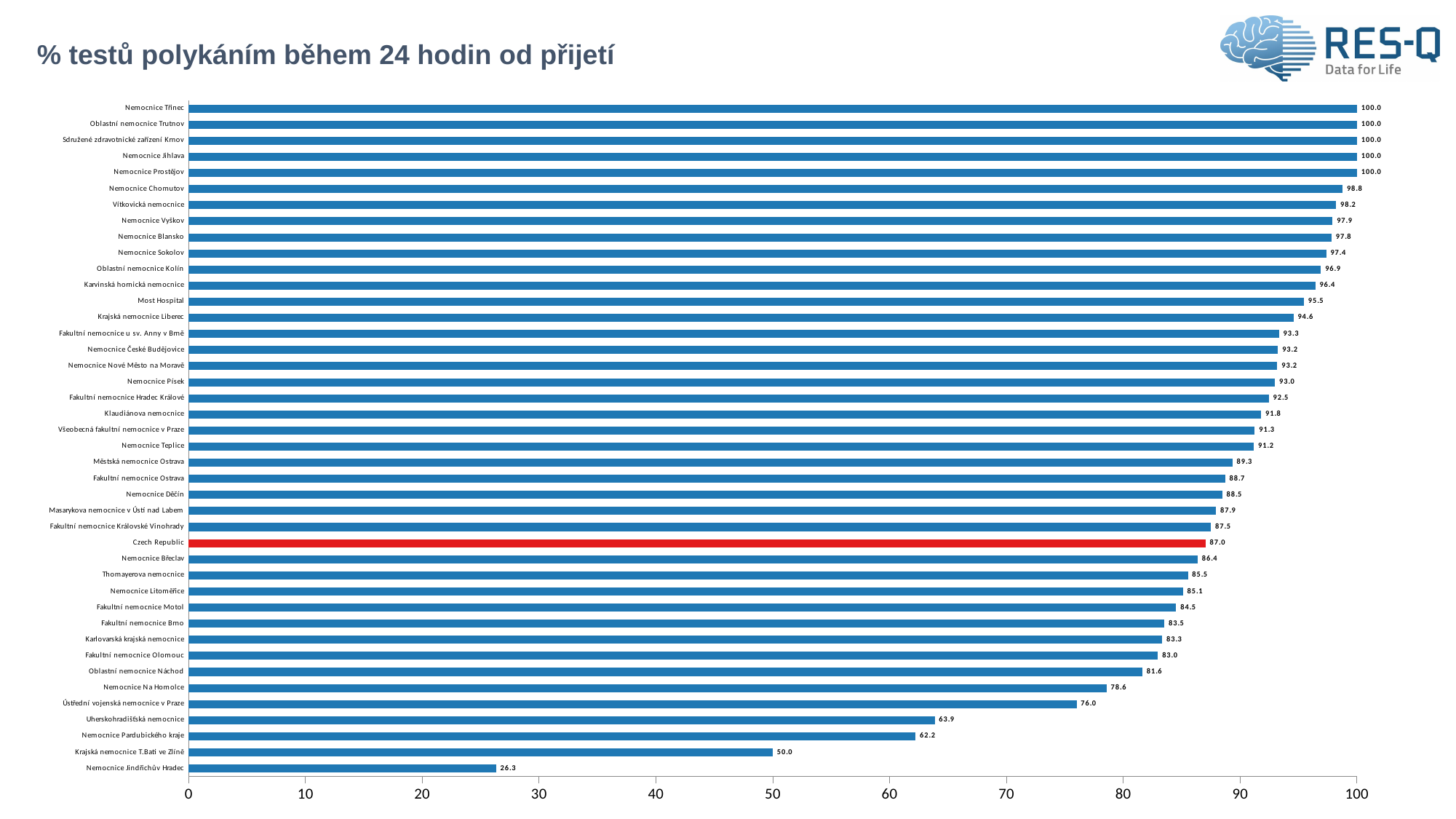
What is the value for Czech Republic? 87.0 What is the title of the chart? % testů polykáním během 24 hodin od přijetí What kind of chart is shown on the slide? bar chart What is the difference between the values for Czech Republic and Nemocnice Na Homolce? 8.4 Which is larger, the value for Nemocnice Chomutov or the value for Nemocnice Teplice? Nemocnice Chomutov What is the value for Fakultní nemocnice Motol? 84.5 Is the value for Uherskohradišťská nemocnice greater or less than 70? less How many categories are shown in the chart? 42 What is the value for Nemocnice Jindřichův Hradec? 26.3 Which category has the lowest value? Nemocnice Jindřichův Hradec What is the value for Most Hospital? 95.5 What is the difference between the values for Krajská nemocnice T.Bati ve Zlíně and Nemocnice Jindřichův Hradec? 23.7